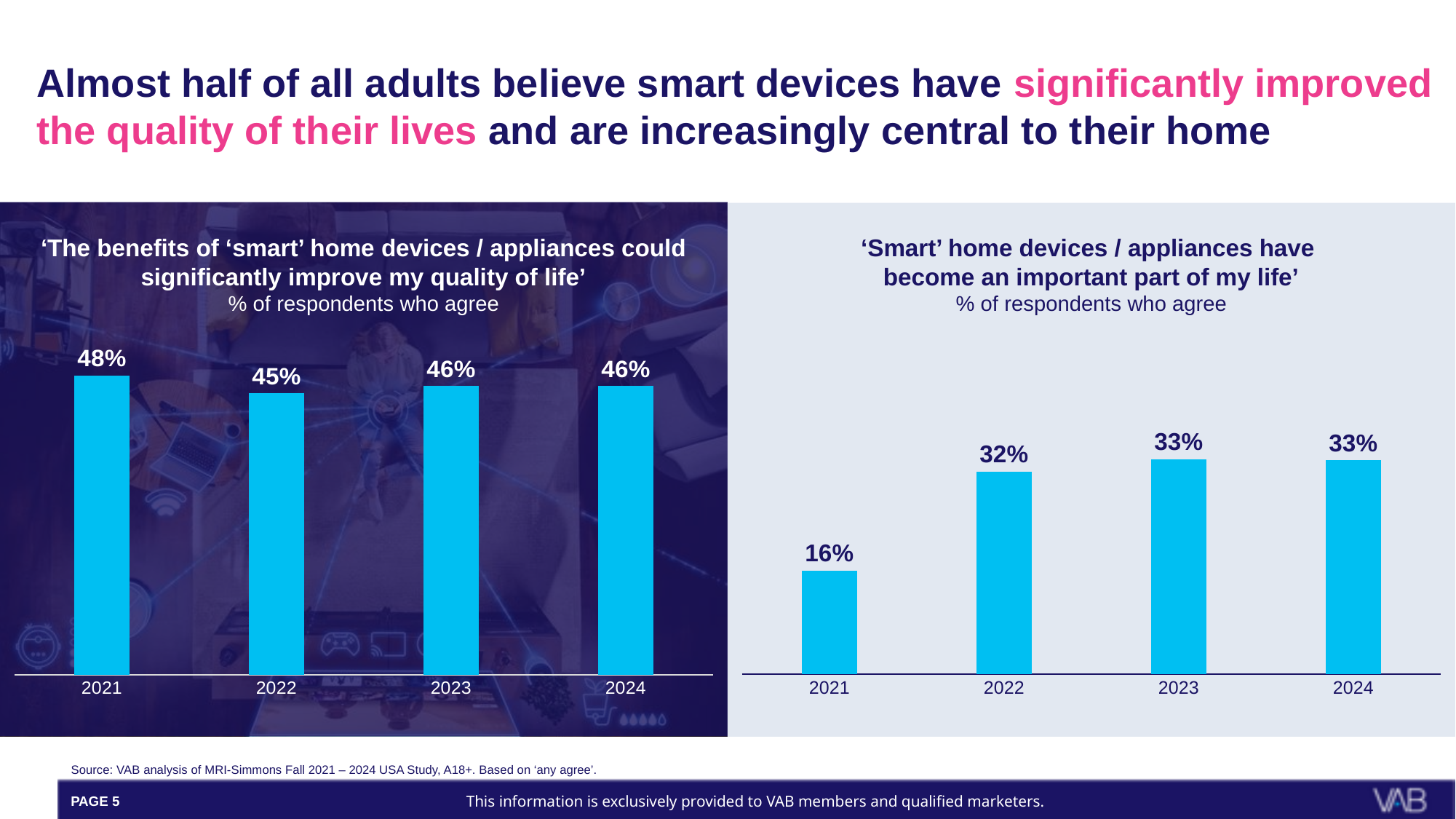
How many years are shown in the left chart ('The benefits of smart home devices could significantly improve my quality of life')? 4 In the right chart ('Smart home devices have become an important part of my life'), what is the value for 2024? 33% In the right chart ('Smart home devices have become an important part of my life'), do the values generally rise or fall from 2021 to 2024? rise In the right chart ('Smart home devices have become an important part of my life'), what percentage of respondents agreed in 2021? 16% What type of chart is the right chart ('Smart home devices have become an important part of my life')? bar chart In the right chart ('Smart home devices have become an important part of my life'), is the value for 2022 larger or smaller than the value for 2021? larger In the right chart ('Smart home devices have become an important part of my life'), which year has the lowest value? 2021 In the left chart ('The benefits of smart home devices could significantly improve my quality of life'), which year has the highest value? 2021 In the left chart ('The benefits of smart home devices could significantly improve my quality of life'), what is the value for 2022? 45% In the left chart ('The benefits of smart home devices could significantly improve my quality of life'), what percentage of respondents agreed in 2021? 48% In the left chart ('The benefits of smart home devices could significantly improve my quality of life'), what is the difference between the 2021 and 2022 values? 3 percentage points In the right chart ('Smart home devices have become an important part of my life'), what is the difference between the 2022 and 2021 values? 16 percentage points